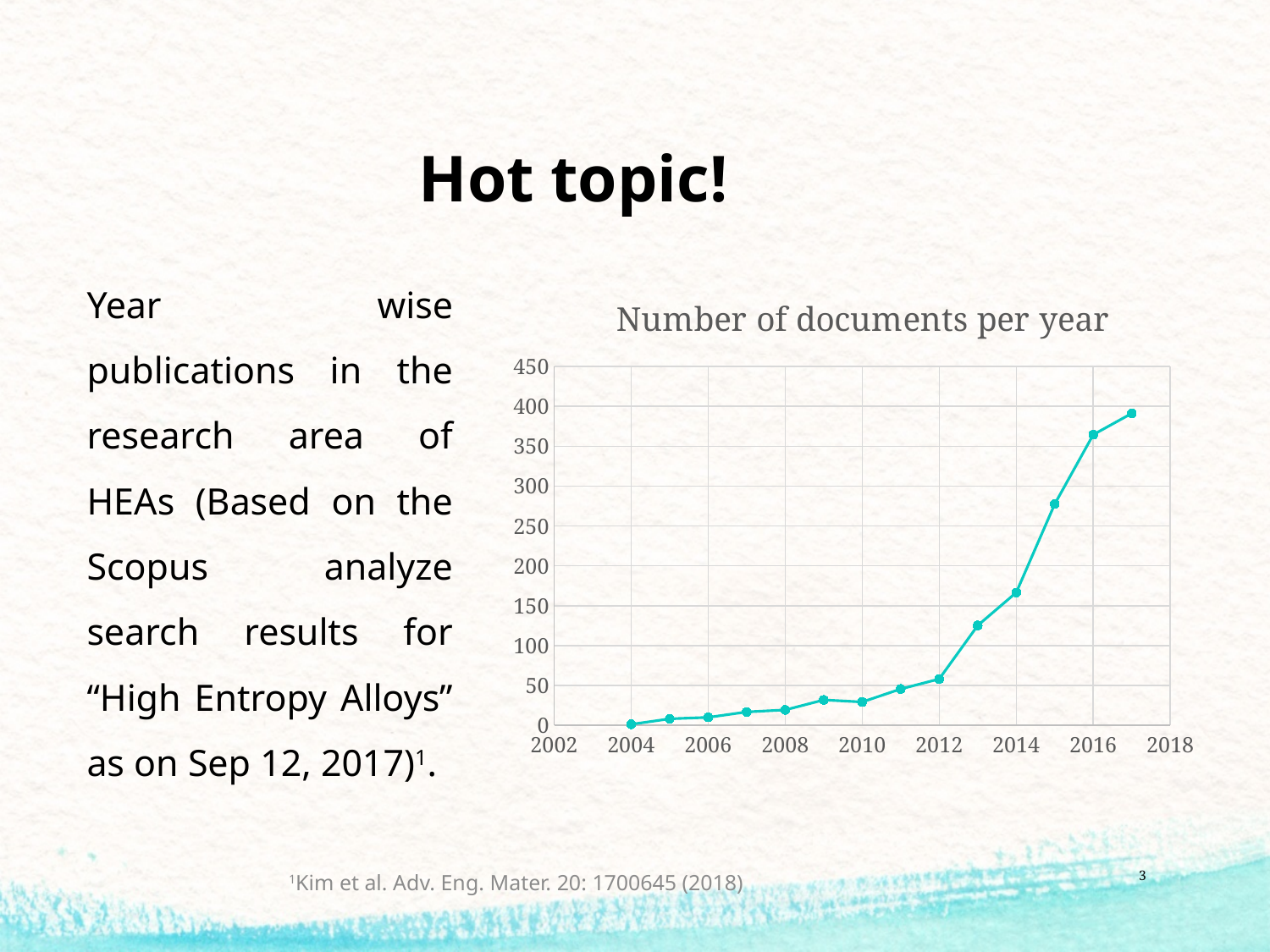
Is the value for 2014 greater or less than 150? greater What is the title of the chart? Number of documents per year Do the values generally rise or fall from 2004 to 2017? rise What kind of chart is shown on the slide? line chart Which year has the lowest number of documents? 2004 Which year has the larger value, 2012 or 2013? 2013 Is the value for 2015 greater or less than 300? less Is the value for 2017 greater or less than 350? greater Which year has the larger value, 2015 or 2016? 2016 Which year has the highest number of documents? 2017 How many data points are plotted on the line? 14